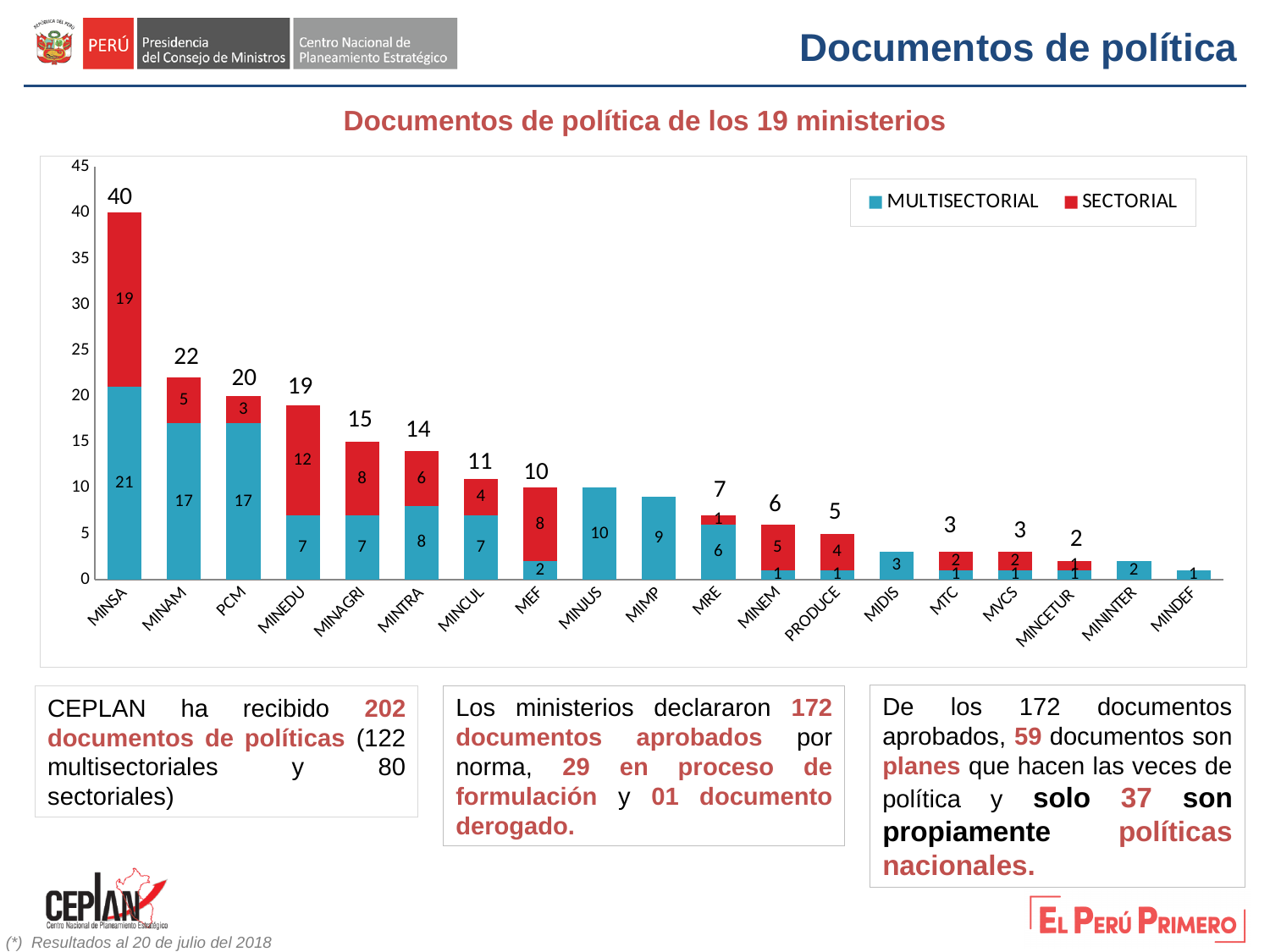
Which has a larger SECTORIAL value, MINEDU or MINAGRI? MINEDU What is the MULTISECTORIAL value for MINSA? 21 How many ministries (categories) are shown on the x axis of the chart? 19 Do the bar totals rise or fall moving from left to right along the x axis? Fall What is the difference between the total for MINSA and the total for MINAM? 18 What is the SECTORIAL value for MINEDU? 12 Which ministry has the lowest total number of policy documents? MINDEF What is the total of the stacked bar for MINAM? 22 How many series does the chart legend list? 2 Which ministry has the highest total number of policy documents? MINSA What is the MULTISECTORIAL value for MEF? 2 What kind of chart is shown on the slide? Stacked bar chart